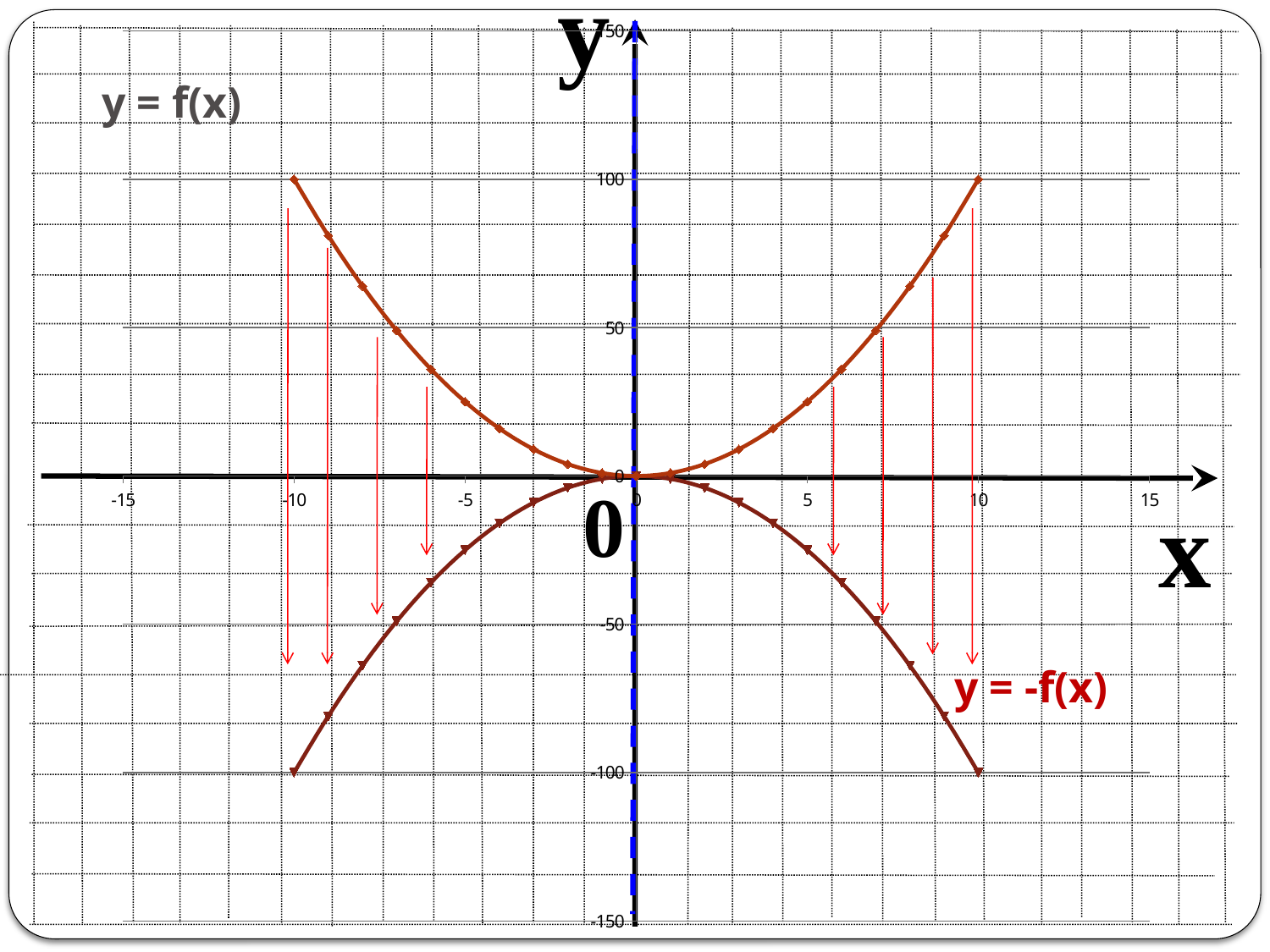
What kind of chart is shown on the slide? line chart What is the value of y = -f(x) at x = -10? -100 At x = 5, which curve has the larger value, y = f(x) or y = -f(x)? y = f(x) How many curves are plotted on the chart? 2 Is the value of y = -f(x) at x = 5 greater or less than 0? less What is the value of y = f(x) at x = 0? 0 What are the labels of the two curves on the chart? y = f(x) and y = -f(x) What is the value of y = -f(x) at x = 10? -100 For x greater than 0, does the curve y = -f(x) rise or fall as x increases? fall What is the value of y = f(x) at x = -10? 100 What is the value of y = f(x) at x = 10? 100 Is the value of y = f(x) at x = 5 greater or less than 50? less